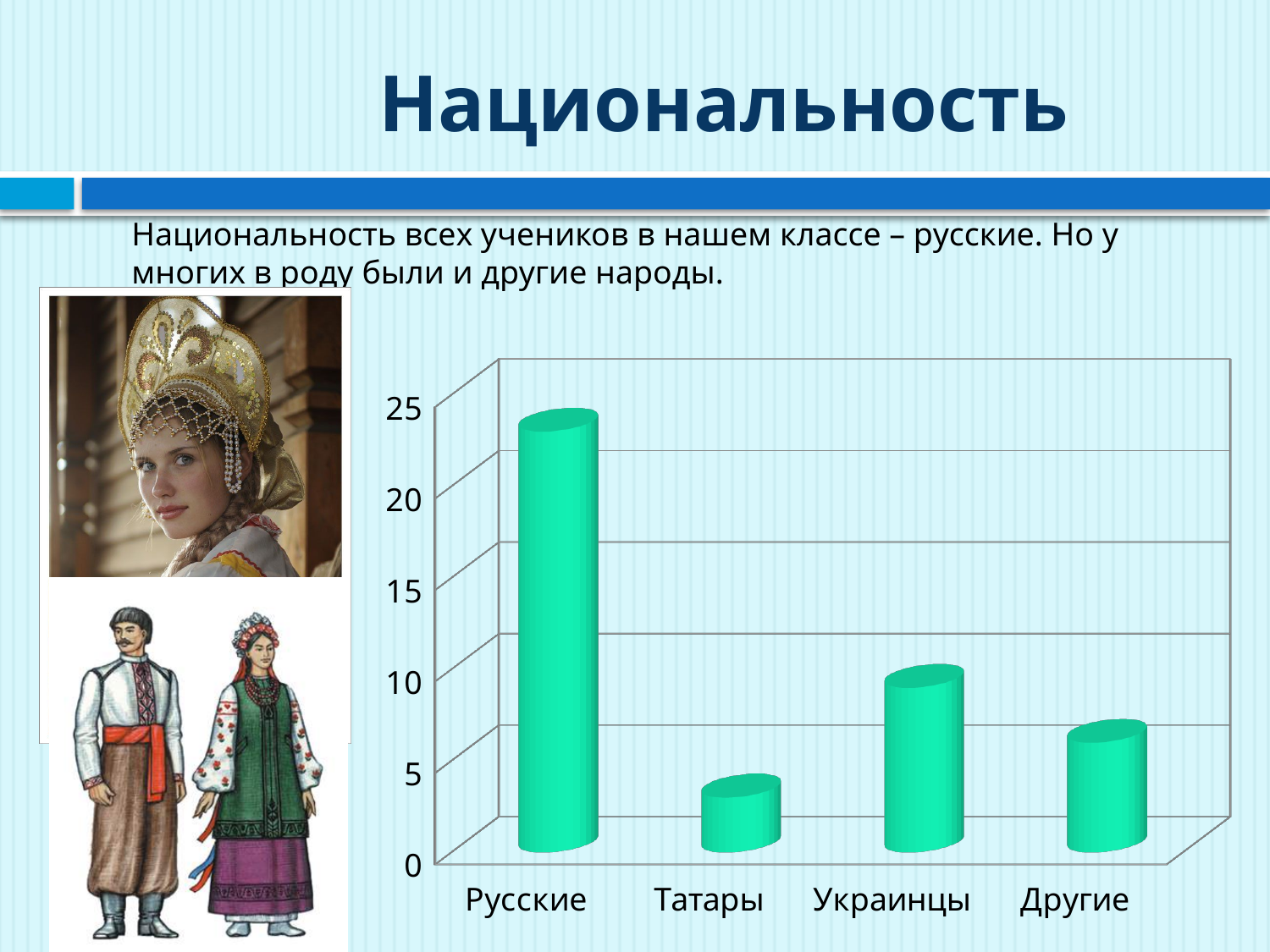
Is the value for Другие greater or less than 10? less What kind of chart is shown on the slide? bar chart What is the highest value labelled on the vertical axis of the chart? 25 Is the value for Татары greater or less than 5? less Is the value for Украинцы greater or less than 5? greater Which is larger, the value for Татары or the value for Другие? Другие Which category has the highest bar in the chart? Русские Which category has the lowest bar in the chart? Татары How many categories are shown on the x axis of the chart? 4 Which is larger, the value for Украинцы or the value for Другие? Украинцы